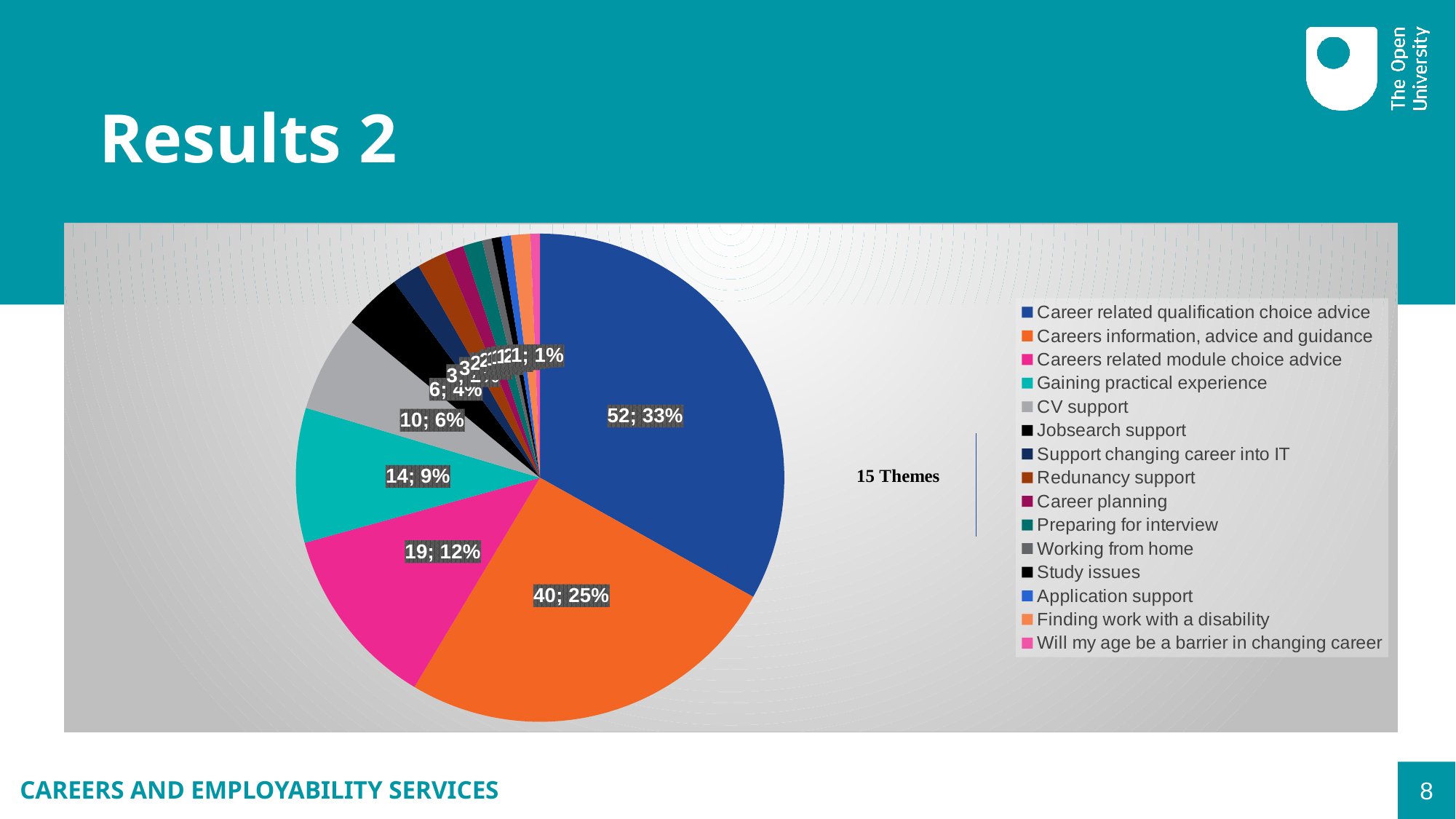
What is the value for Career related qualification choice advice? 52 What is the value for Careers related module choice advice? 19 What is the value for CV support? 10 What is the difference between the values for Career related qualification choice advice and Careers information, advice and guidance? 12 What kind of chart is shown on the slide? pie chart How many themes (slices) does the pie chart show? 15 Which is larger, the value for Gaining practical experience or the value for CV support? Gaining practical experience Which theme has the largest slice of the pie? Career related qualification choice advice What share of the pie does Careers information, advice and guidance take? 25% What share of the pie does Career related qualification choice advice take? 33% What is the value for Careers information, advice and guidance? 40 What share of the pie does Gaining practical experience take? 9%